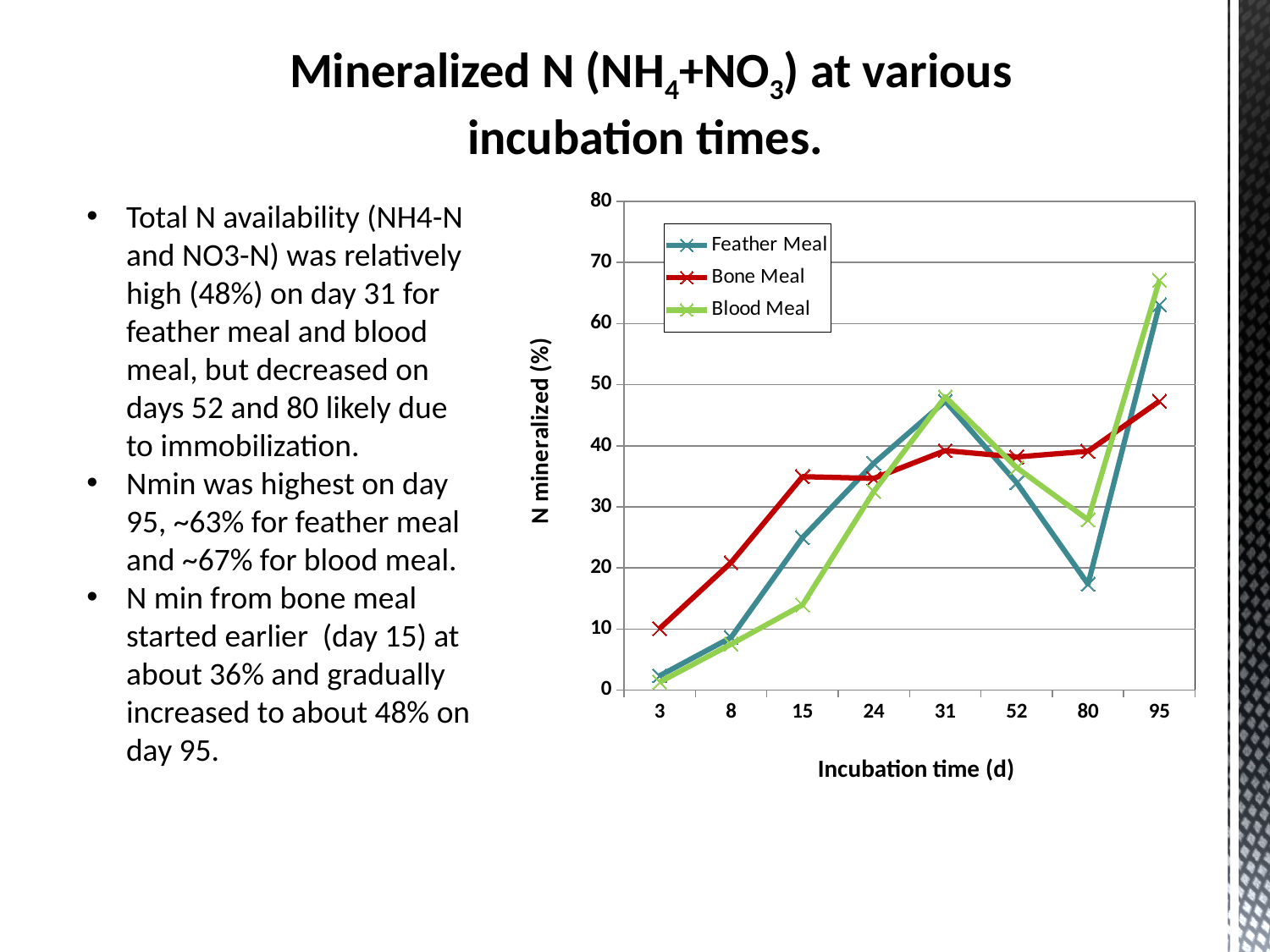
How many incubation time points are shown on the x axis? 8 Is the value for Bone Meal at incubation time 15 greater or less than 30? greater At incubation time 15, which is larger: Bone Meal or Blood Meal? Bone Meal How many series does the chart legend list? 3 Which series has the highest value at incubation time 3? Bone Meal Does the Bone Meal series rise or fall from incubation time 3 to incubation time 15? rise Is the value for Blood Meal at incubation time 95 greater or less than 60? greater Which series has the highest value at incubation time 95? Blood Meal What is the title of the y axis? N mineralized (%) Which series has the lowest value at incubation time 80? Feather Meal What kind of chart is shown on the slide? line chart Is the value for Bone Meal at incubation time 3 greater or less than 20? less